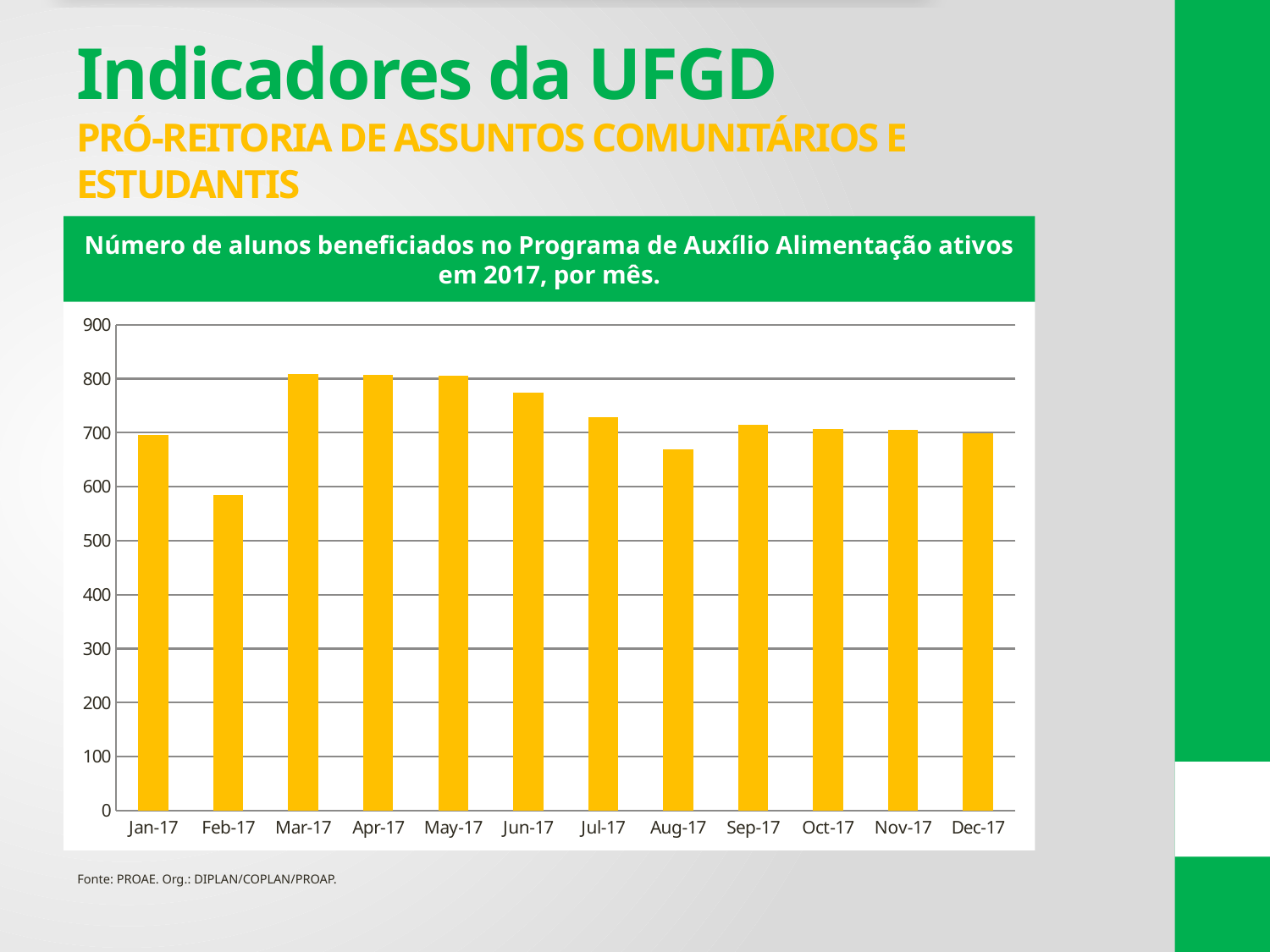
Is the value for Feb-17 greater or less than 600? less What kind of chart is shown on the slide? bar chart Which is larger, the value for Feb-17 or the value for Aug-17? Aug-17 What colour are the bars in the chart? yellow Is the value for Jun-17 greater or less than 700? greater Which month has the lowest number of students benefited? Feb-17 What is the title of the chart? Número de alunos beneficiados no Programa de Auxílio Alimentação ativos em 2017, por mês. Is the value for Aug-17 greater or less than 700? less Which is larger, the value for Jun-17 or the value for Jul-17? Jun-17 Do the values rise or fall from Mar-17 to Aug-17? fall How many months are plotted on the chart? 12